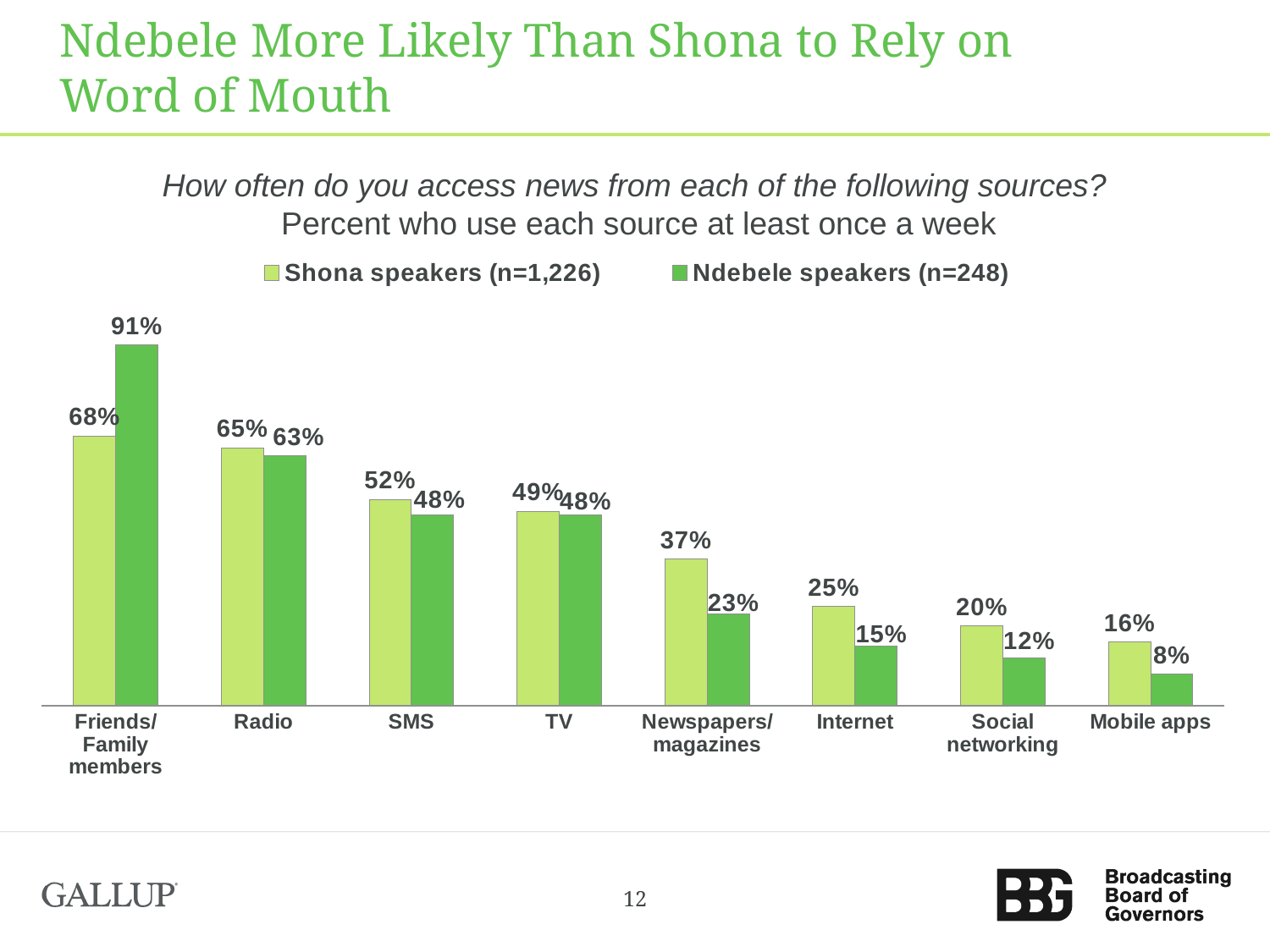
What kind of chart is shown on the slide? Bar chart How many news sources are shown on the x axis? 8 How many series does the legend list? 2 What is the difference between Shona speakers and Ndebele speakers for Internet? 10 percentage points Which news source has the lowest value for Ndebele speakers? Mobile apps Which news source has the highest value for Shona speakers? Friends/Family members For Radio, which group has the higher value, Shona speakers or Ndebele speakers? Shona speakers What is the difference between Ndebele speakers and Shona speakers for Friends/Family members? 23 percentage points What is the sample size (n) for Ndebele speakers shown in the legend? 248 What is the value for Shona speakers for Newspapers/magazines? 37% What is the value for Ndebele speakers for Mobile apps? 8% What percentage of Ndebele speakers access news from friends/family members at least once a week? 91%